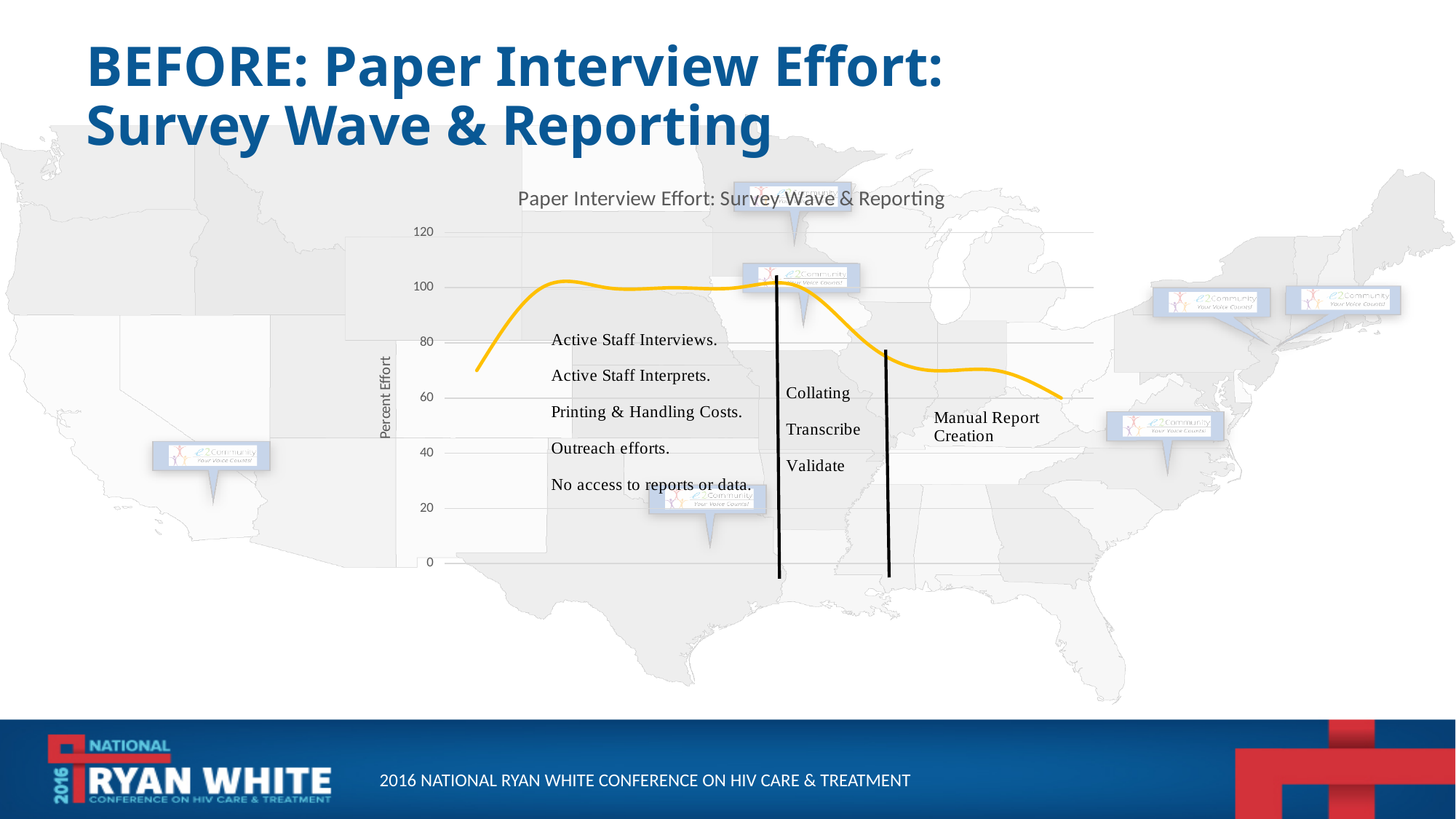
Does the line rise or fall between the 'Collating / Transcribe / Validate' phase and the 'Manual Report Creation' phase? fall What is the label of the vertical axis of the chart? Percent Effort Does the line rise or fall at the start of the chart, before reaching its plateau? rise Is the value at the left end of the line greater or less than 40? greater What is the highest tick value shown on the vertical axis? 120 Is the value at the right end of the line greater or less than 80? less What kind of chart is shown on the slide? line chart Is the value of the line in the 'Manual Report Creation' phase greater or less than 100? less How many phases are marked off by the vertical black lines on the chart? 3 What is the title of the chart? Paper Interview Effort: Survey Wave & Reporting